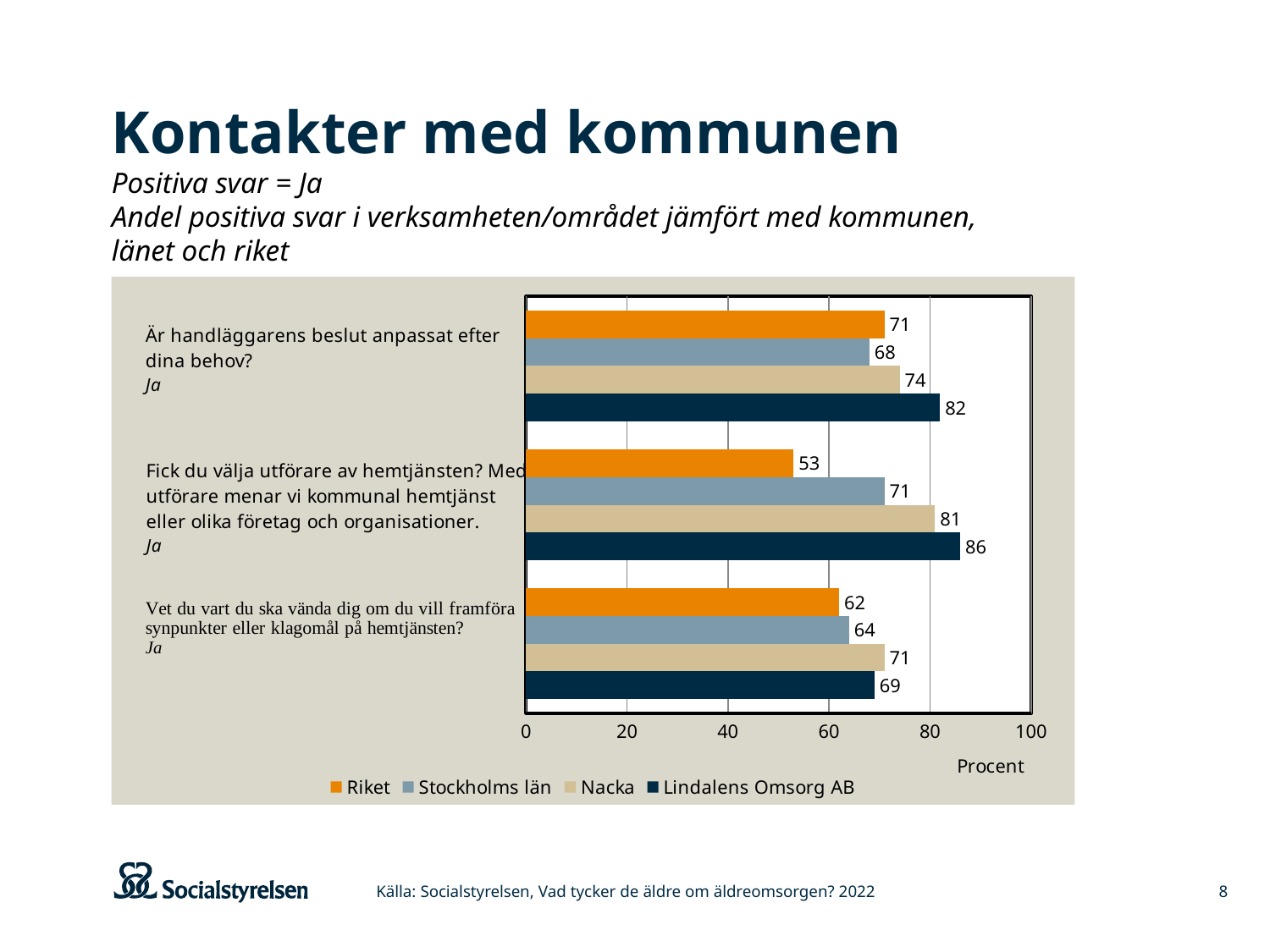
What is the value for Nacka on the question "Vet du vart du ska vända dig om du vill framföra synpunkter eller klagomål på hemtjänsten?"? 71 Which series has the highest value on the question "Fick du välja utförare av hemtjänsten?"? Lindalens Omsorg AB What unit is shown on the horizontal axis of the chart? Procent What is the difference between Lindalens Omsorg AB and Riket on the question "Fick du välja utförare av hemtjänsten?"? 33 How many series does the legend list? 4 On the question "Vet du vart du ska vända dig om du vill framföra synpunkter eller klagomål på hemtjänsten?", which is larger: Nacka or Lindalens Omsorg AB? Nacka What is the value for Lindalens Omsorg AB on the question "Är handläggarens beslut anpassat efter dina behov?"? 82 How many questions (categories) are shown in the chart? 3 What kind of chart is shown on the slide? bar chart Which series has the lowest value on the question "Är handläggarens beslut anpassat efter dina behov?"? Stockholms län What is the value for Riket on the question "Fick du välja utförare av hemtjänsten?"? 53 Is the value for Riket on the question "Fick du välja utförare av hemtjänsten?" greater or less than 60? less